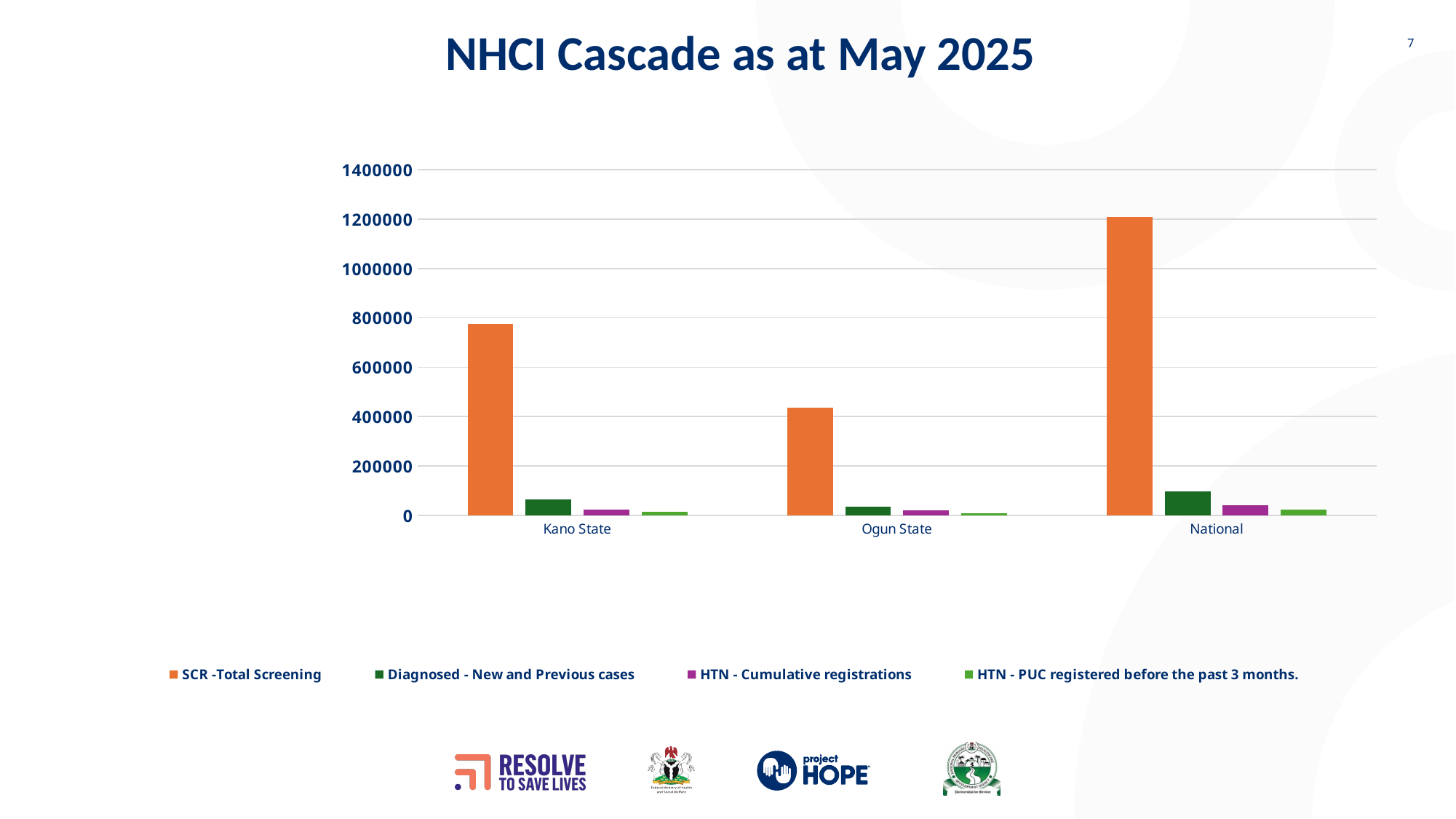
Which category has the lowest SCR -Total Screening value? Ogun State How many categories are shown on the x axis? 3 What is the title of the chart? NHCI Cascade as at May 2025 Is the SCR -Total Screening value for National greater or less than 1000000? greater Which colour represents HTN - Cumulative registrations in the legend? purple Is the SCR -Total Screening value for Ogun State greater or less than 400000? greater How many series does the legend list? 4 Which category has the highest SCR -Total Screening value? National Is the SCR -Total Screening value for Kano State greater or less than 600000? greater Which is larger, the SCR -Total Screening value for Kano State or for Ogun State? Kano State Which category has the highest Diagnosed - New and Previous cases value? National What kind of chart is shown on the slide? bar chart